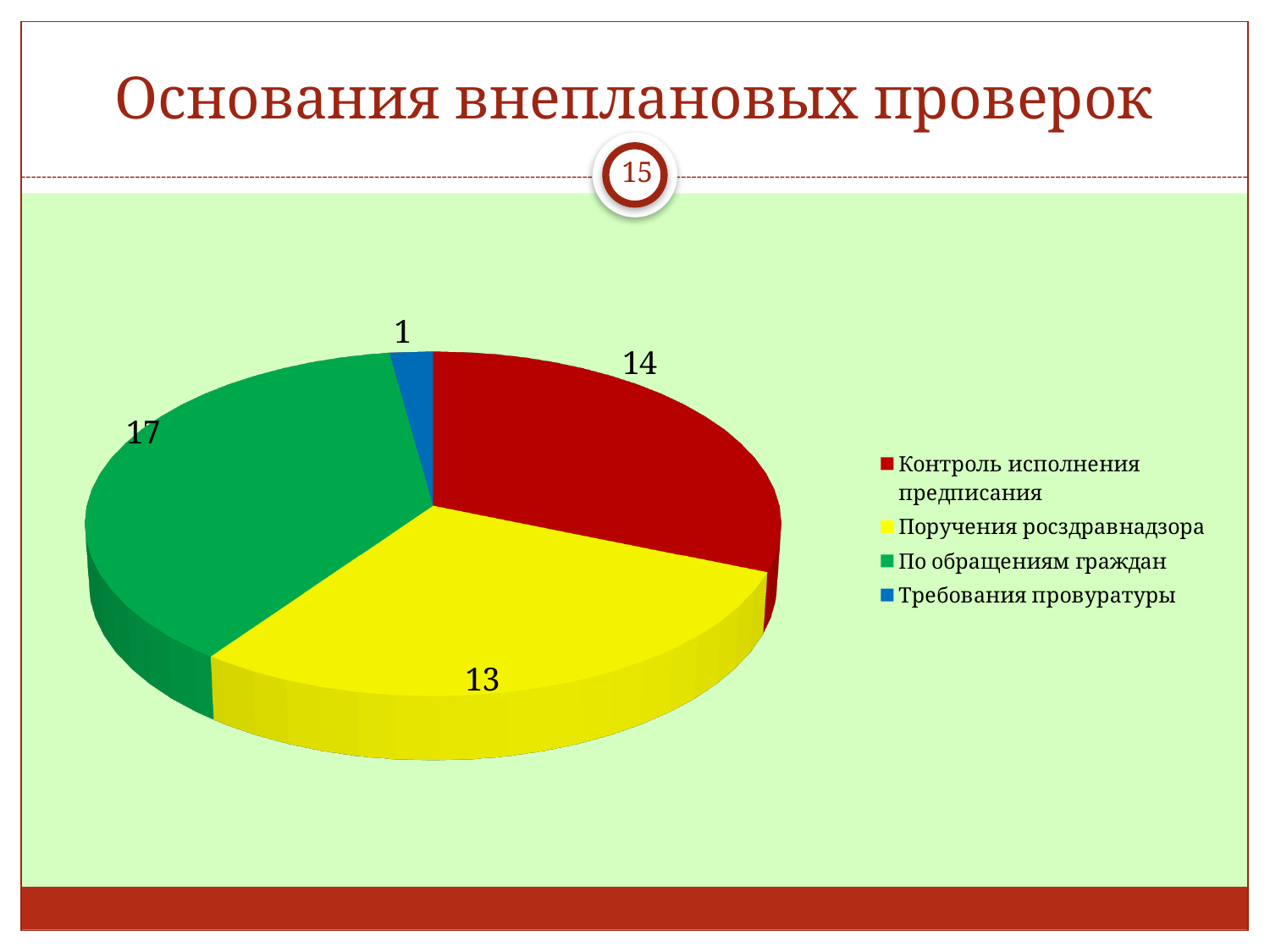
What is the total of all slices in the pie chart? 45 Which is larger: «Контроль исполнения предписания» or «Поручения росздравнадзора»? Контроль исполнения предписания What is the value for «Контроль исполнения предписания»? 14 What is the difference between the values for «По обращениям граждан» and «Поручения росздравнадзора»? 4 What is the value for «Поручения росздравнадзора»? 13 Which category has the smallest slice of the pie? Требования провуратуры What colour is the slice for «Поручения росздравнадзора»? Yellow What type of chart is shown on the slide? Pie chart What is the value for «Требования провуратуры»? 1 Which category has the largest slice of the pie? По обращениям граждан How many categories does the pie chart have? 4 What is the value for «По обращениям граждан»? 17